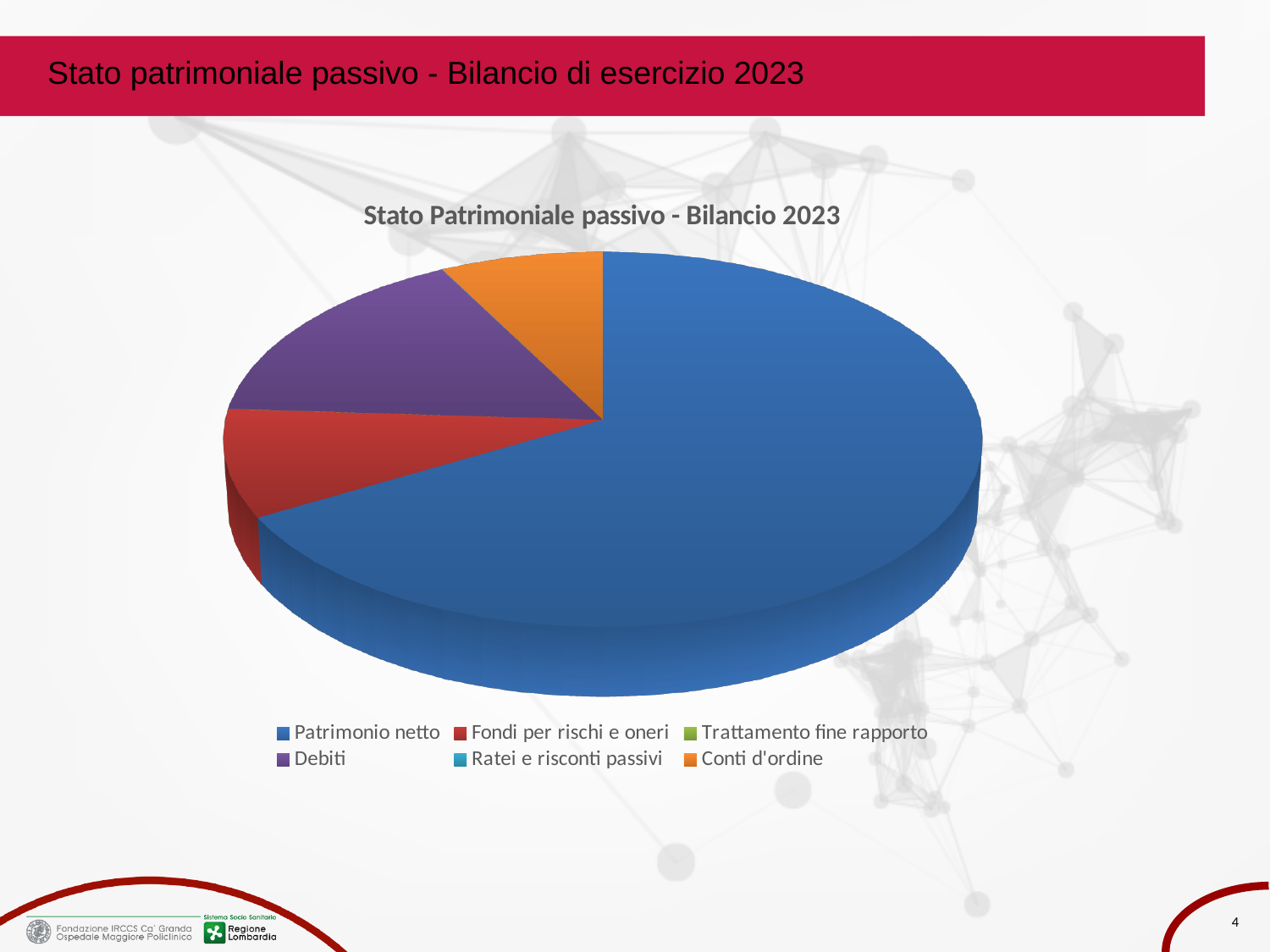
Which is larger, the slice for Debiti or the slice for Fondi per rischi e oneri? Debiti Which is larger, the slice for Patrimonio netto or the slice for Fondi per rischi e oneri? Patrimonio netto How many categories does the chart's legend list? 6 Which is larger, the slice for Debiti or the slice for Conti d'ordine? Debiti Does the slice for Patrimonio netto make up more or less than half of the pie? More Which category has the largest slice of the pie? Patrimonio netto What colour is the slice for Patrimonio netto? Blue What is the title of the chart? Stato Patrimoniale passivo - Bilancio 2023 What kind of chart is shown on the slide? Pie chart